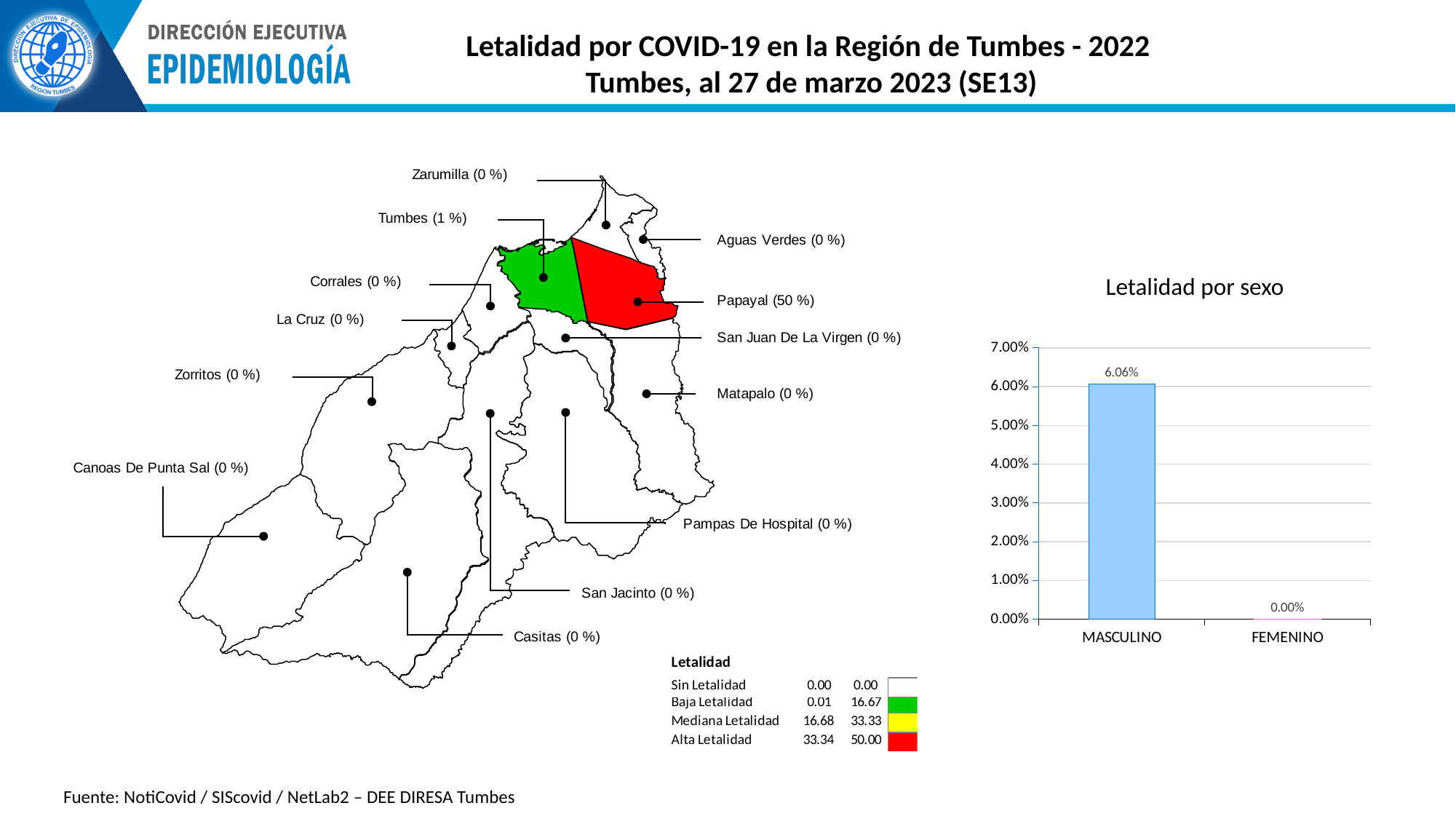
On the map, what is the lethality percentage shown for Papayal? 50 % What is the highest value shown on the y axis of the 'Letalidad por sexo' chart? 7.00% On the map, what is the lethality percentage shown for Tumbes? 1 % In the 'Letalidad por sexo' chart, what is the value for MASCULINO? 6.06% In the 'Letalidad por sexo' chart, what is the difference between the MASCULINO and FEMENINO values? 6.06% What kind of chart is 'Letalidad por sexo'? bar chart In the 'Letalidad por sexo' chart, which is larger, the value for MASCULINO or for FEMENINO? MASCULINO How many categories are shown on the x axis of the 'Letalidad por sexo' chart? 2 In the 'Letalidad por sexo' chart, which category has the lowest value? FEMENINO In the 'Letalidad por sexo' chart, which category has the highest value? MASCULINO In the 'Letalidad por sexo' chart, what is the value for FEMENINO? 0.00% In the 'Letalidad por sexo' chart, is the value for MASCULINO greater or less than 5.00%? greater